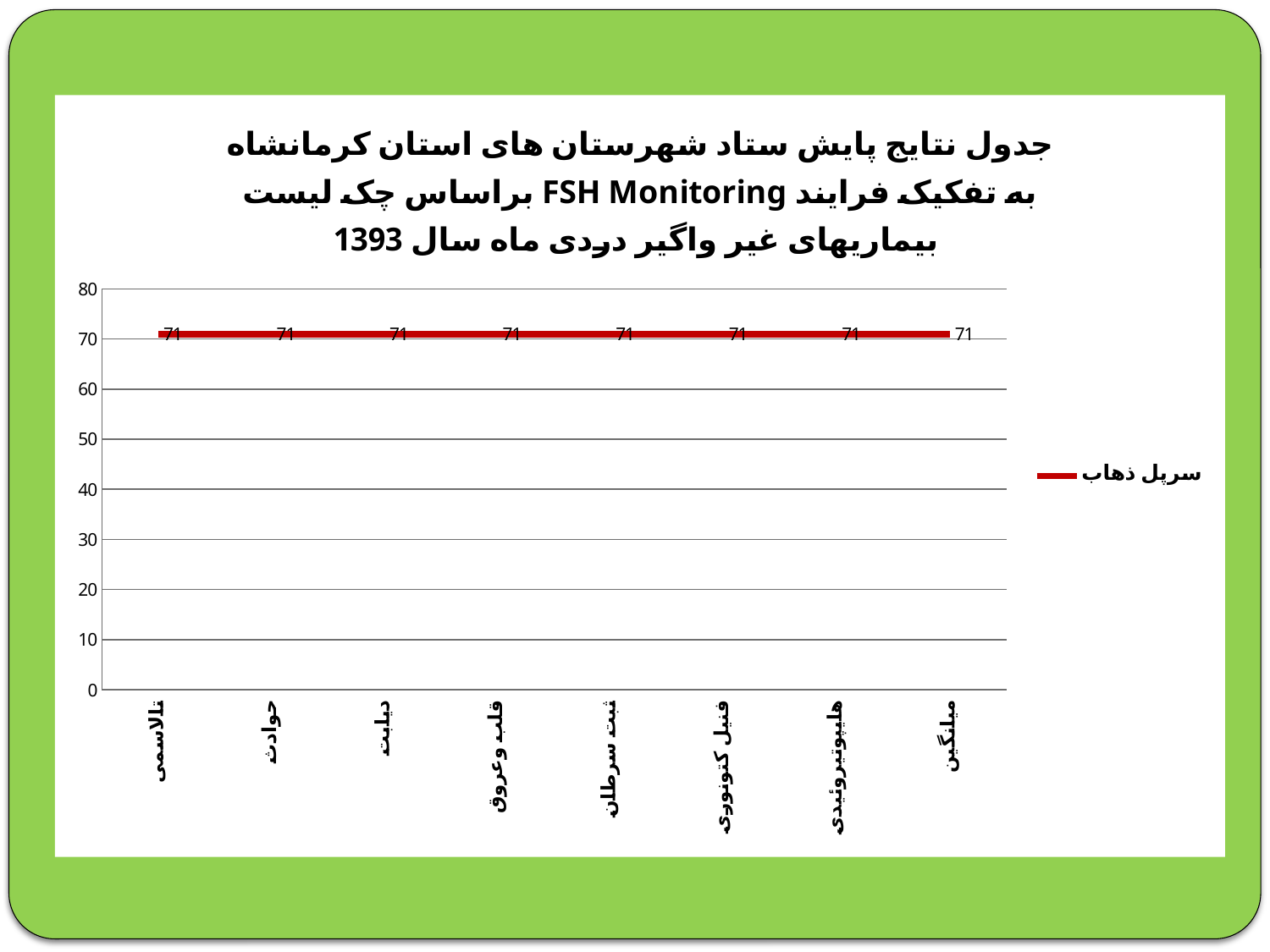
Do the values rise, fall, or stay flat across the categories? stay flat What kind of chart is shown on the slide? line chart What is the difference between the values for حوادث and هیپوتیروئیدی? 0 How many categories are shown on the x axis? 8 What is the value for میانگین? 71 What is the value for تالاسمی? 71 How many series does the legend list? 1 What is the value for دیابت? 71 What is the name of the series shown in the legend? سرپل ذهاب What is the value for ثبت سرطان? 71 Is the value for قلب و عروق greater or less than 60? greater Is the value for فنیل کتونوری greater or less than 80? less